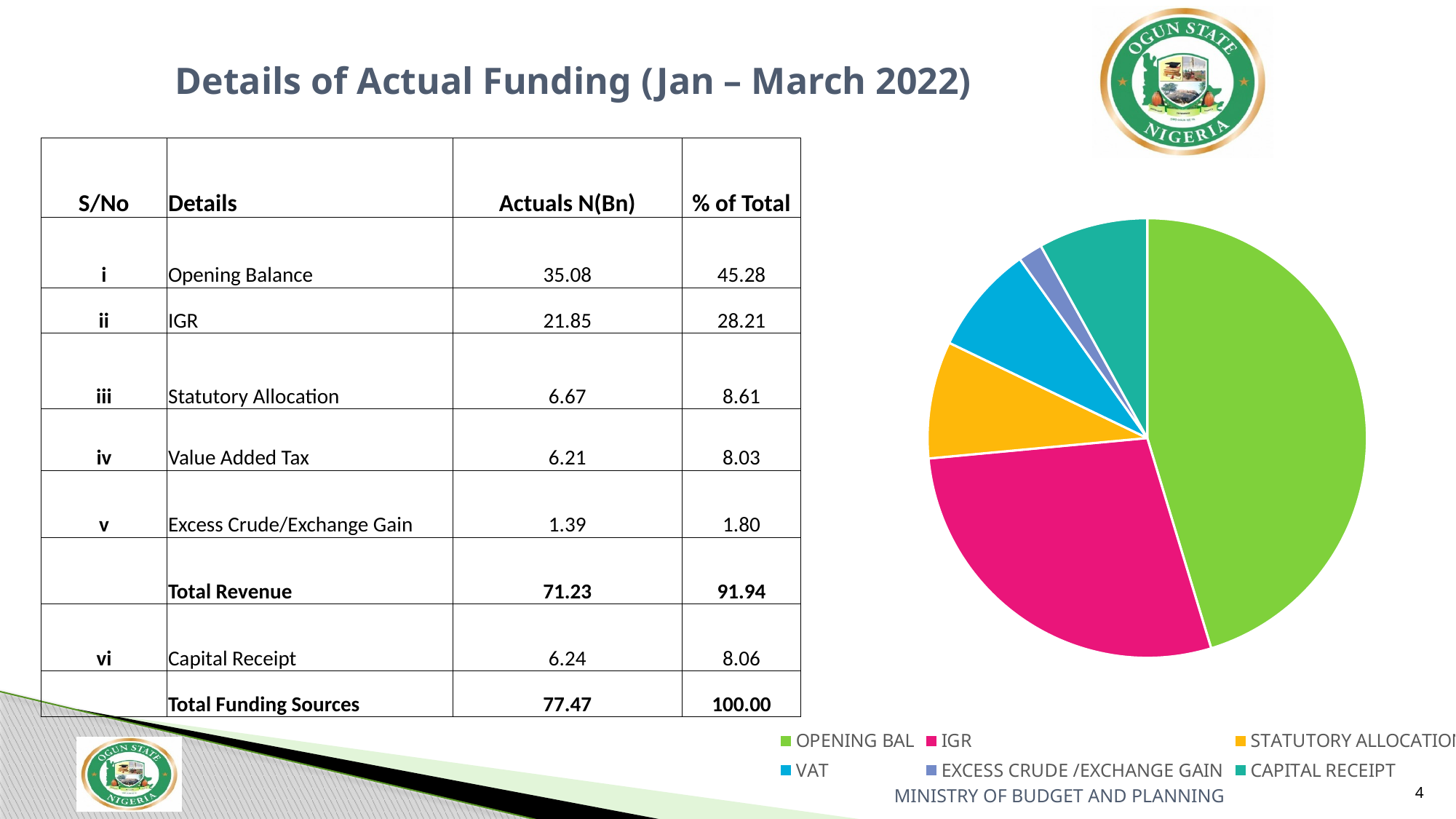
How many entries does the pie chart's legend list? 6 What colour is the IGR slice in the pie chart? pink Which category has the largest slice in the pie chart? OPENING BAL What kind of chart is shown on the slide? pie chart Which category has the smallest slice in the pie chart? EXCESS CRUDE /EXCHANGE GAIN In the pie chart, which slice is larger: OPENING BAL or IGR? OPENING BAL How many slices does the pie chart have? 6 What colour is the OPENING BAL slice in the pie chart? green In the pie chart, which slice is larger: CAPITAL RECEIPT or EXCESS CRUDE /EXCHANGE GAIN? CAPITAL RECEIPT In the pie chart, which slice is larger: IGR or VAT? IGR